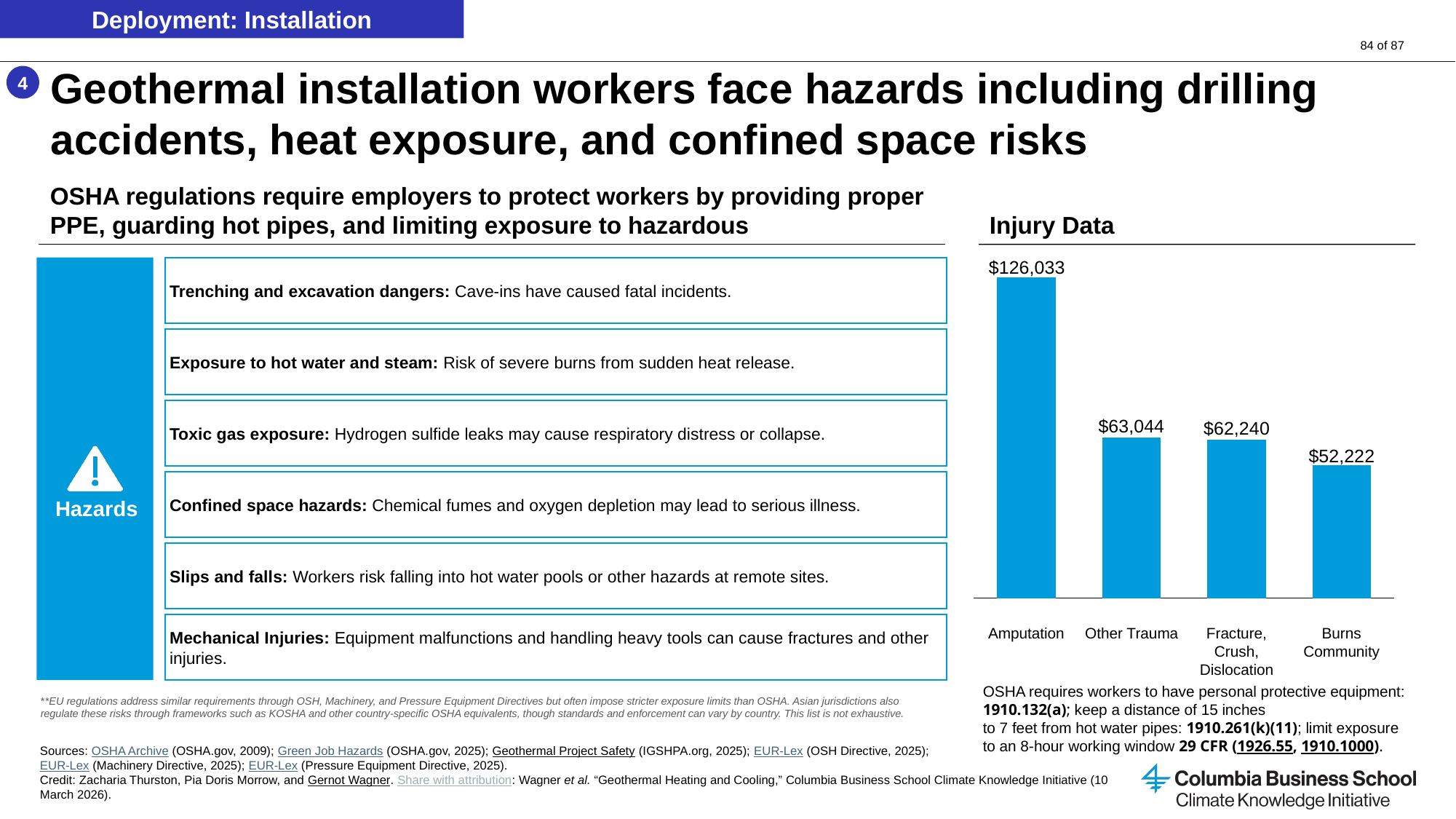
What is the value for Other Trauma in the Injury Data chart? $63,044 In the Injury Data chart, which is larger: Other Trauma or Fracture, Crush, Dislocation? Other Trauma What is the value for Fracture, Crush, Dislocation in the Injury Data chart? $62,240 What is the difference between the Amputation and Other Trauma values in the Injury Data chart? $62,989 What is the value for Burns Community in the Injury Data chart? $52,222 What is the value for Amputation in the Injury Data chart? $126,033 What type of chart is the Injury Data chart? Bar chart What is the difference between the Fracture, Crush, Dislocation and Burns Community values in the Injury Data chart? $10,018 What is the title of the chart on the right side of the slide? Injury Data Which category has the highest value in the Injury Data chart? Amputation Which category has the lowest value in the Injury Data chart? Burns Community How many categories are shown in the Injury Data chart? 4